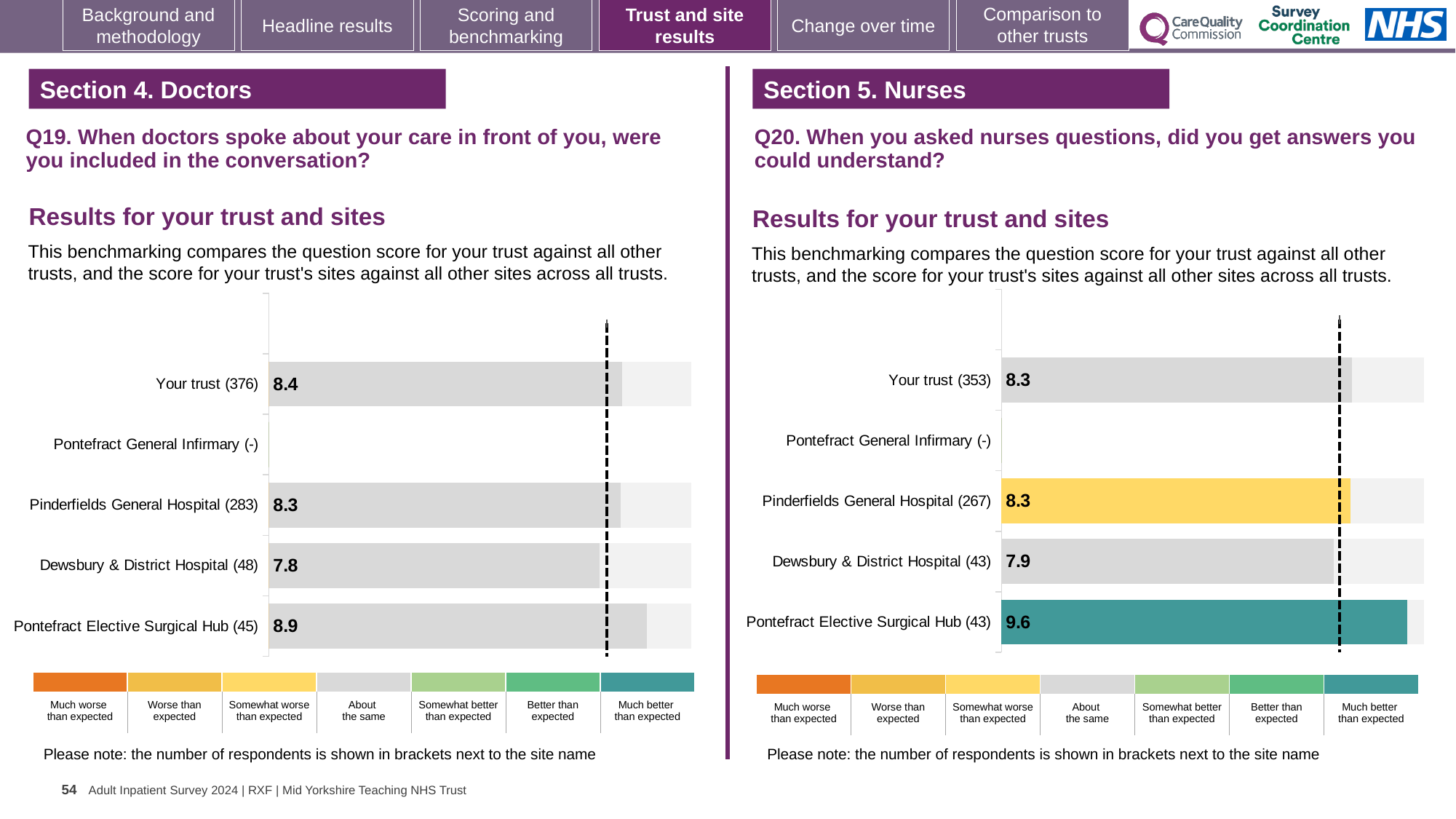
On the Q20 chart (right), what is the score for Pontefract Elective Surgical Hub? 9.6 On the Q20 chart (right), which site has the lowest score among those with a value shown? Dewsbury & District Hospital On the Q20 chart (right), which benchmark category does the colour of the Pontefract Elective Surgical Hub bar indicate? Much better than expected On the Q19 chart (left), what is the score for Dewsbury & District Hospital? 7.8 What kind of chart is used on the Q19 chart (left)? Bar chart On the Q19 chart (left), what is the difference between the scores for Pontefract Elective Surgical Hub and Dewsbury & District Hospital? 1.1 On the Q20 chart (right), which is larger: the score for Pontefract Elective Surgical Hub or the score for Your trust? Pontefract Elective Surgical Hub On the Q19 chart (left), which site has the highest score? Pontefract Elective Surgical Hub On the Q20 chart (right), what is the score for Dewsbury & District Hospital? 7.9 On the Q19 chart (left), how many respondents are shown in brackets for Pinderfields General Hospital? 283 On the Q20 chart (right), what is the difference between the scores for Pontefract Elective Surgical Hub and Pinderfields General Hospital? 1.3 On the Q19 chart (left), what is the score for Your trust? 8.4